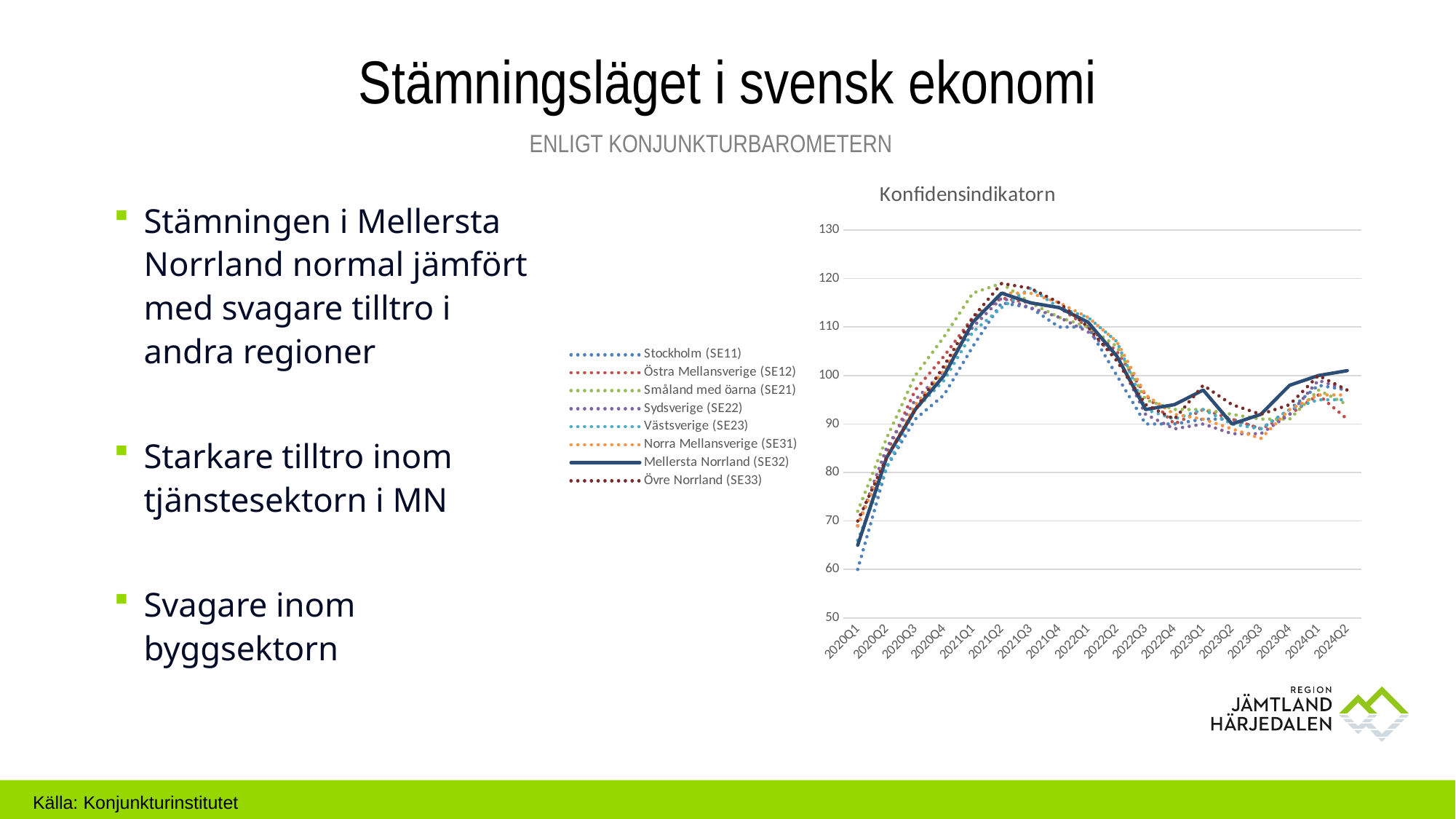
How many series does the chart legend list? 8 What kind of chart is shown on the slide? line chart Is the value for Mellersta Norrland (SE32) in 2020Q1 greater or less than 70? less In which quarter does Mellersta Norrland (SE32) reach its highest value? 2021Q2 How many quarters are shown along the x axis of the chart? 18 Do the values for Mellersta Norrland (SE32) rise or fall from 2020Q1 to 2021Q2? rise Is the value for Mellersta Norrland (SE32) in 2024Q2 greater or less than 90? greater Is the value for Mellersta Norrland (SE32) in 2021Q2 greater or less than 110? greater Which series is drawn as a solid line rather than a dotted line? Mellersta Norrland (SE32) In which quarter does Mellersta Norrland (SE32) have its lowest value? 2020Q1 What is the title of the chart? Konfidensindikatorn